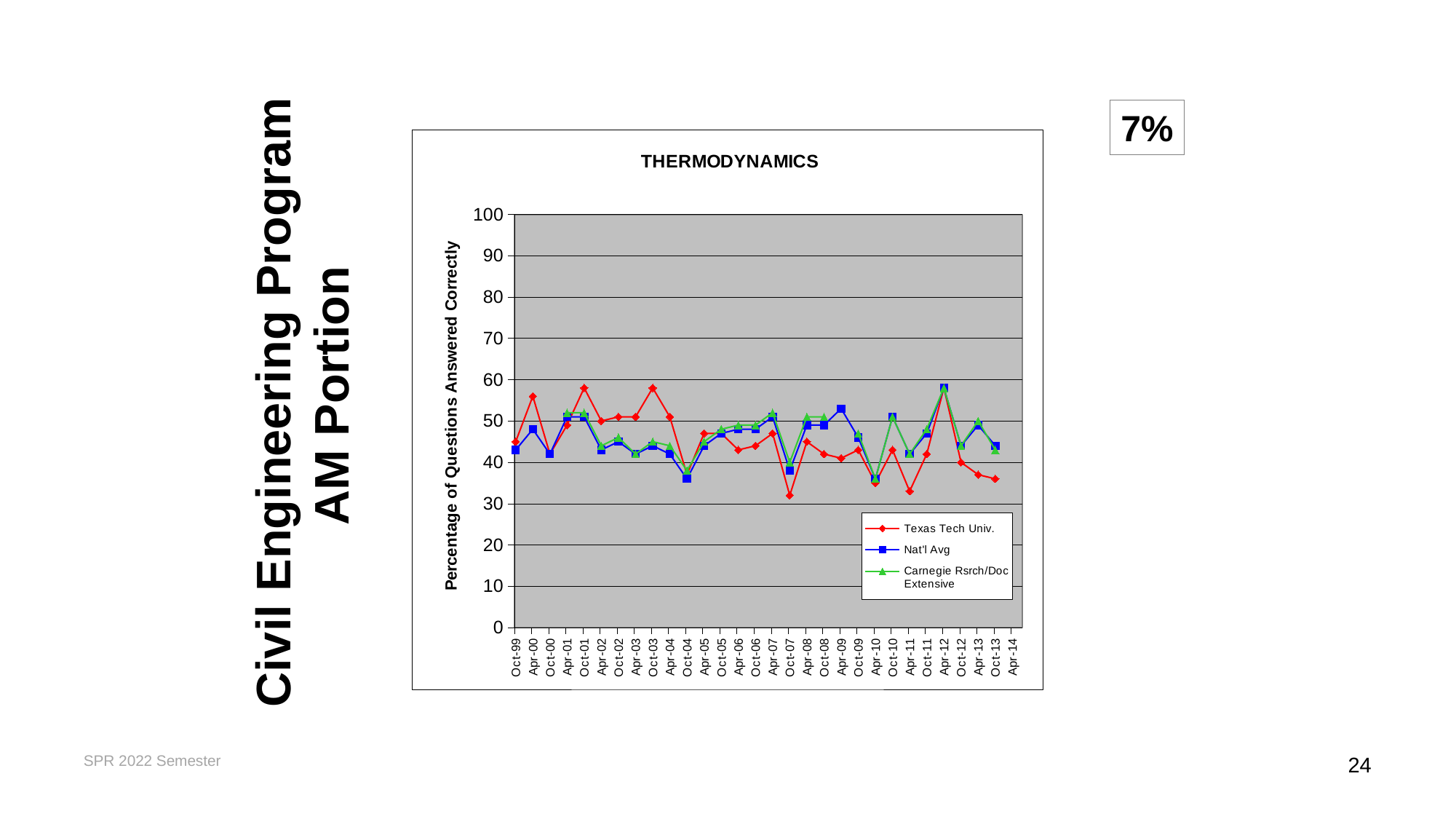
Which series has the highest value at Oct-01? Texas Tech Univ. What kind of chart is shown on the slide? line chart How many series does the chart's legend list? 3 Is the Nat'l Avg value at Apr-12 greater or less than 50? greater Is the Texas Tech Univ. value at Oct-01 greater or less than 50? greater At Oct-07, which is larger: the Texas Tech Univ. value or the Nat'l Avg value? Nat'l Avg At Oct-03, which is larger: the Texas Tech Univ. value or the Carnegie Rsrch/Doc Extensive value? Texas Tech Univ. Is the Texas Tech Univ. value at Oct-07 greater or less than 40? less Which series has the lowest value at Apr-11? Texas Tech Univ. What is the title of the chart? THERMODYNAMICS What is the label on the vertical axis of the chart? Percentage of Questions Answered Correctly